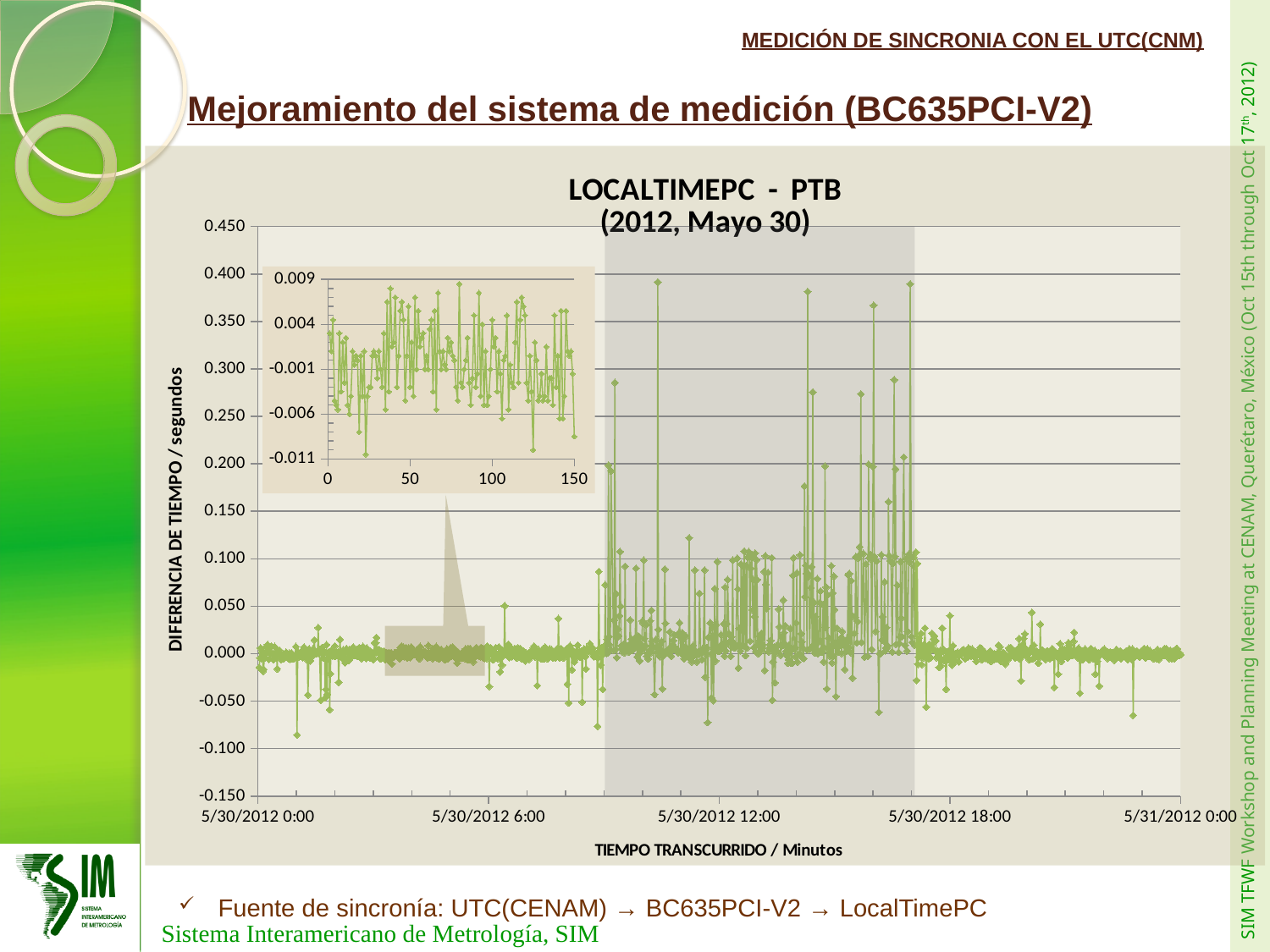
On the main chart, what is the highest value shown on the y-axis? 0.450 On the main chart, is the highest spike in the data greater or less than 0.350? greater How many date-time labels are shown on the x-axis of the main chart? 5 On the inset chart, what is the highest value shown on the y-axis? 0.009 On the inset chart, what is the largest value shown on the x-axis? 150 What is the title of the main chart? LOCALTIMEPC - PTB (2012, Mayo 30) On the main chart, what is the first date-time label on the x-axis? 5/30/2012 0:00 What kind of chart is the main chart on the slide? line chart On the main chart, what is the lowest value shown on the y-axis? -0.150 On the main chart, is the lowest point in the data greater or less than -0.050? less What is the y-axis title of the main chart? DIFERENCIA DE TIEMPO / segundos On the main chart, what is the last date-time label on the x-axis? 5/31/2012 0:00